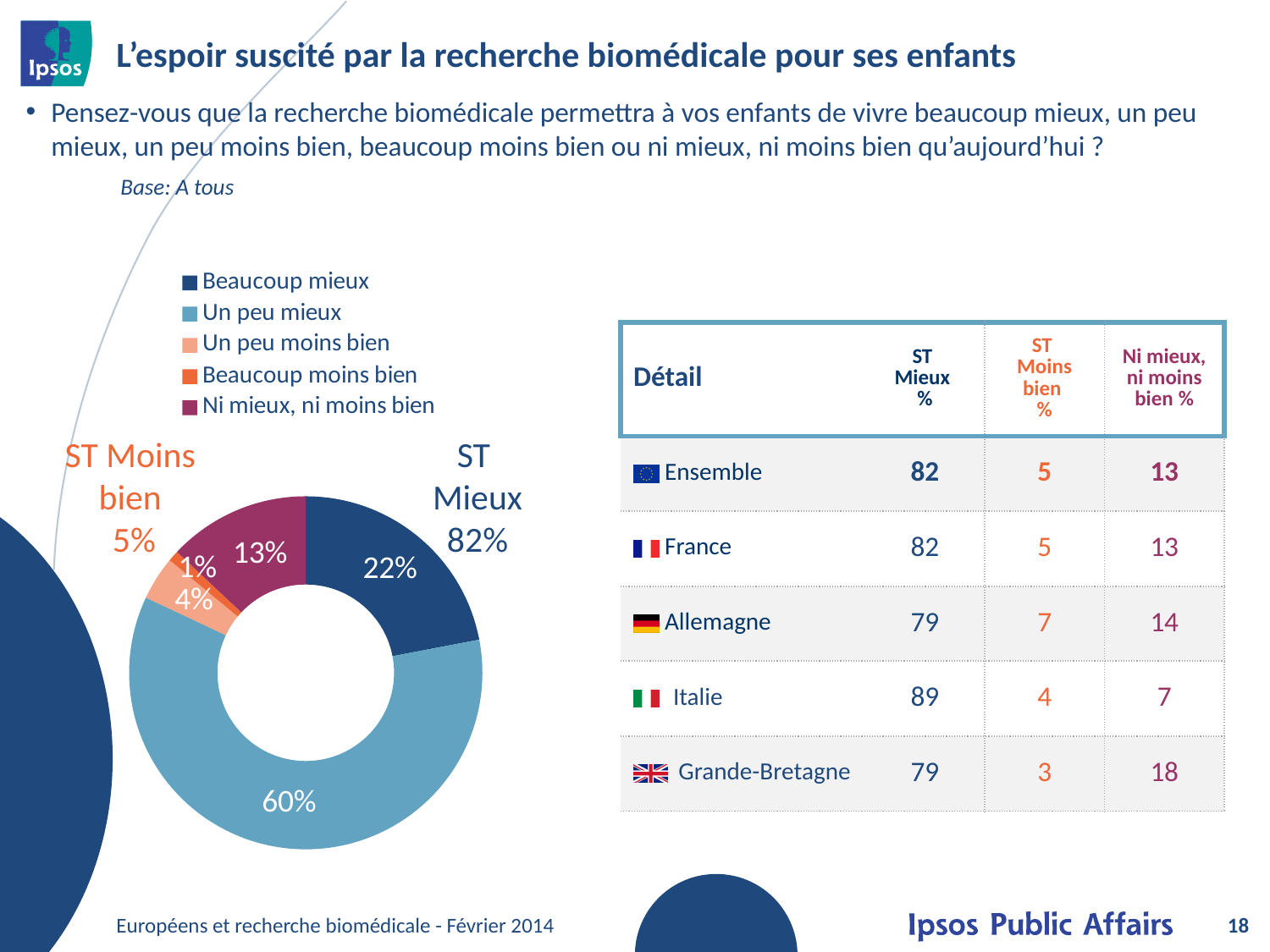
What percentage of the pie chart is 'Beaucoup mieux'? 22% Which category has the smallest slice in the pie chart? Beaucoup moins bien What percentage of the pie chart is 'Un peu mieux'? 60% What percentage of the pie chart is 'Un peu moins bien'? 4% Which category has the largest slice in the pie chart? Un peu mieux What kind of chart is shown on the left of the slide? Pie chart (donut) What percentage of the pie chart is 'Beaucoup moins bien'? 1% What percentage of the pie chart is 'Ni mieux, ni moins bien'? 13% What is the difference between the 'Un peu mieux' and 'Beaucoup mieux' slices in the pie chart? 38% What is the 'ST Mieux' total shown next to the pie chart? 82% Which is larger in the pie chart: 'Ni mieux, ni moins bien' or 'Un peu moins bien'? Ni mieux, ni moins bien How many categories does the pie chart legend list? 5